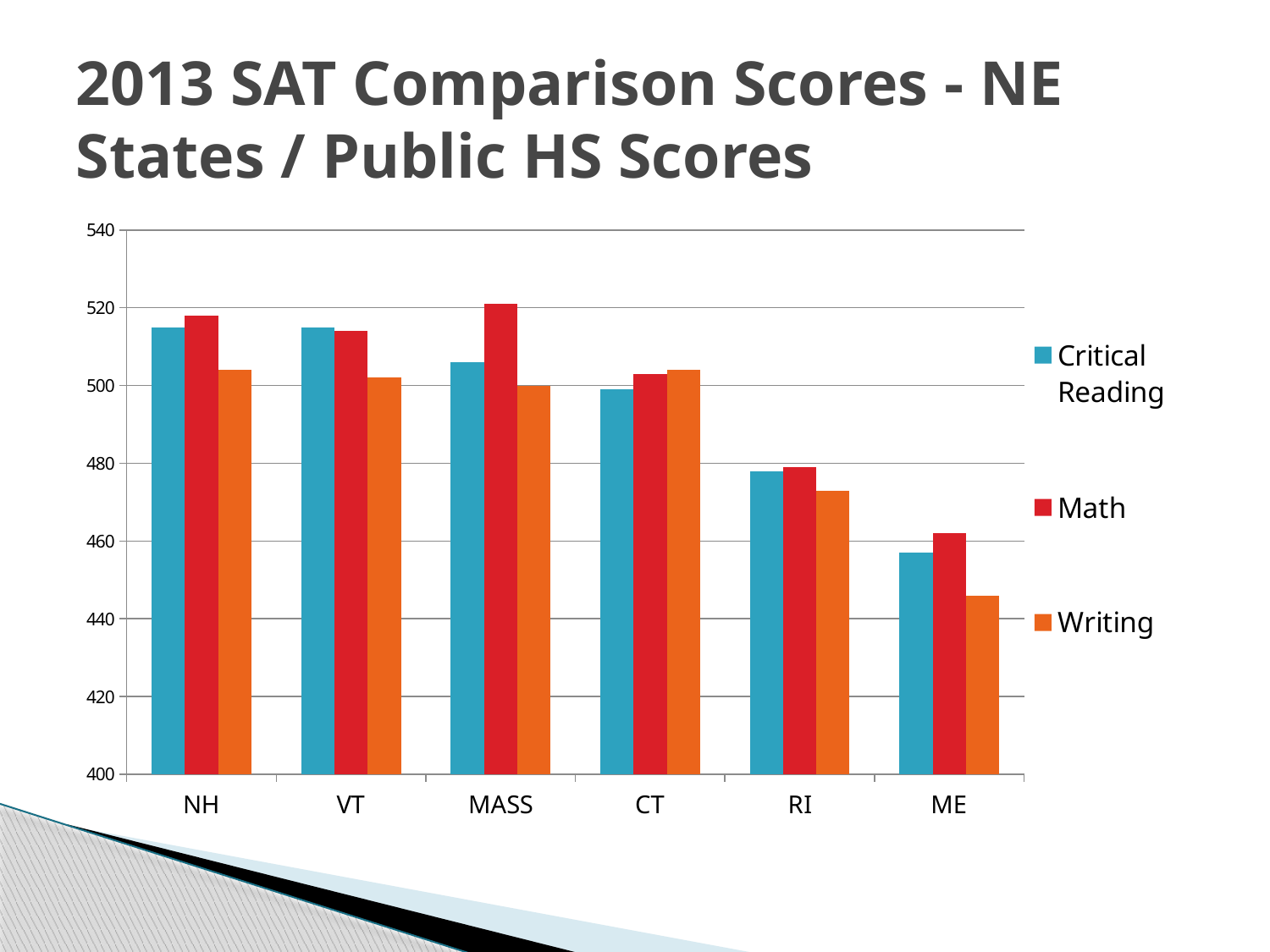
Is the Writing score for RI greater or less than 480? less For MASS, which is larger: the Math score or the Critical Reading score? Math Which state has the highest Math score? MASS Which state has the lowest Critical Reading score? ME How many series does the chart's legend list? 3 Do the Critical Reading scores generally rise or fall moving from NH to ME along the x axis? fall Is the Writing score for ME greater or less than 460? less Which is larger: the Writing score for CT or the Writing score for RI? CT What kind of chart is shown on the slide? Bar chart How many states are shown on the x axis of the chart? 6 Which state has the lowest Writing score? ME Is the Math score for NH greater or less than 500? greater